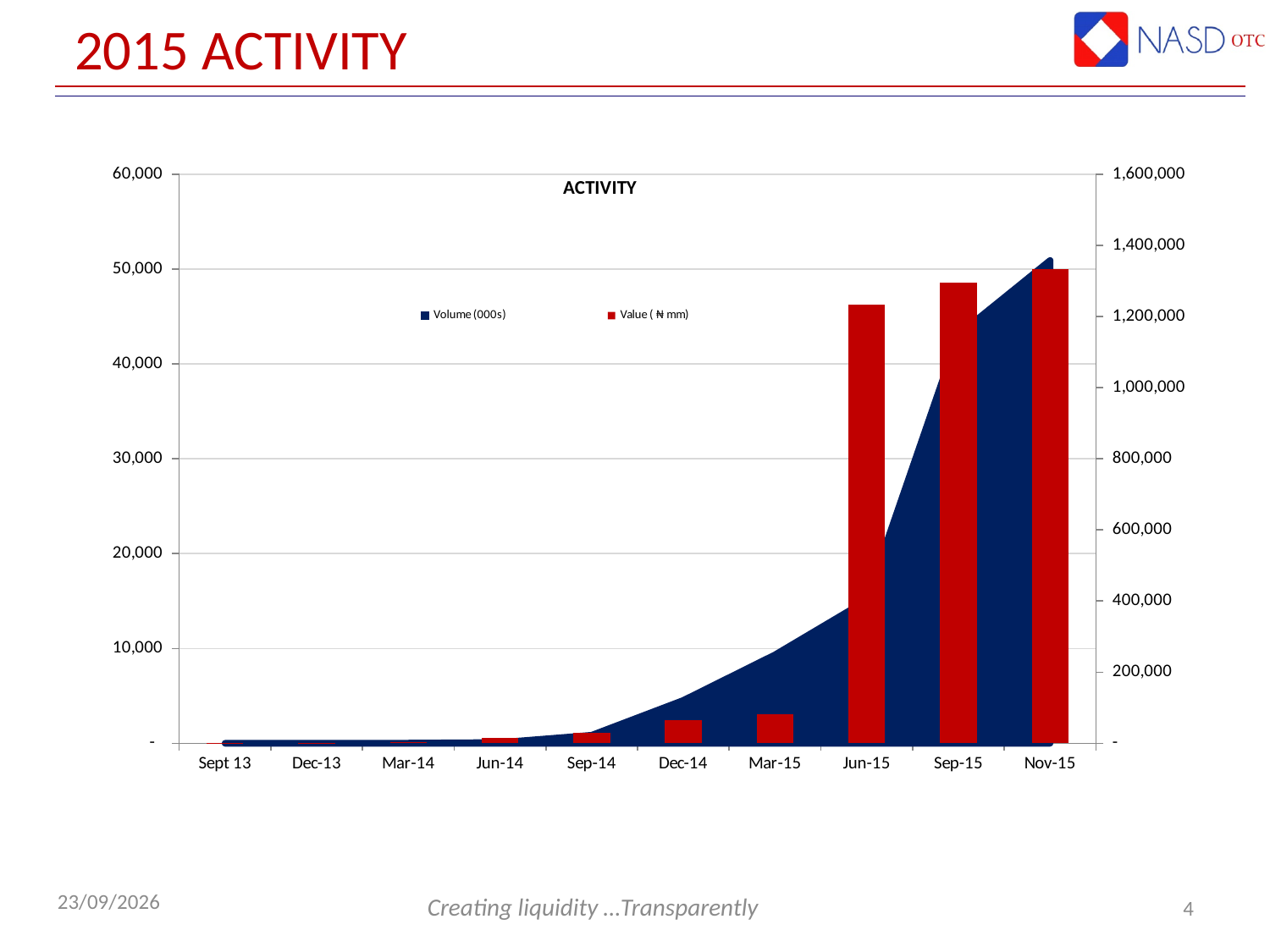
Measured against the left axis, is the Volume (000s) area at Jun-15 greater or less than 10,000? greater Measured against the left axis, is the Value (₦ mm) bar for Jun-15 greater or less than 40,000? greater In which period is the Value (₦ mm) bar the tallest? Nov-15 Does the Volume (000s) series generally rise or fall from Sept 13 to Nov-15? Rise Which period has the taller Value (₦ mm) bar, Mar-15 or Jun-15? Jun-15 How many time periods are shown along the x axis of the chart? 10 What is the title shown inside the chart? ACTIVITY Which colour represents the Value (₦ mm) series in the chart? Red Measured against the left axis, is the Value (₦ mm) bar for Mar-15 greater or less than 10,000? less What kind of chart is shown on the slide? A combination of an area chart and a bar chart How many series does the chart legend list? 2 Which period has the taller Value (₦ mm) bar, Dec-14 or Sep-15? Sep-15